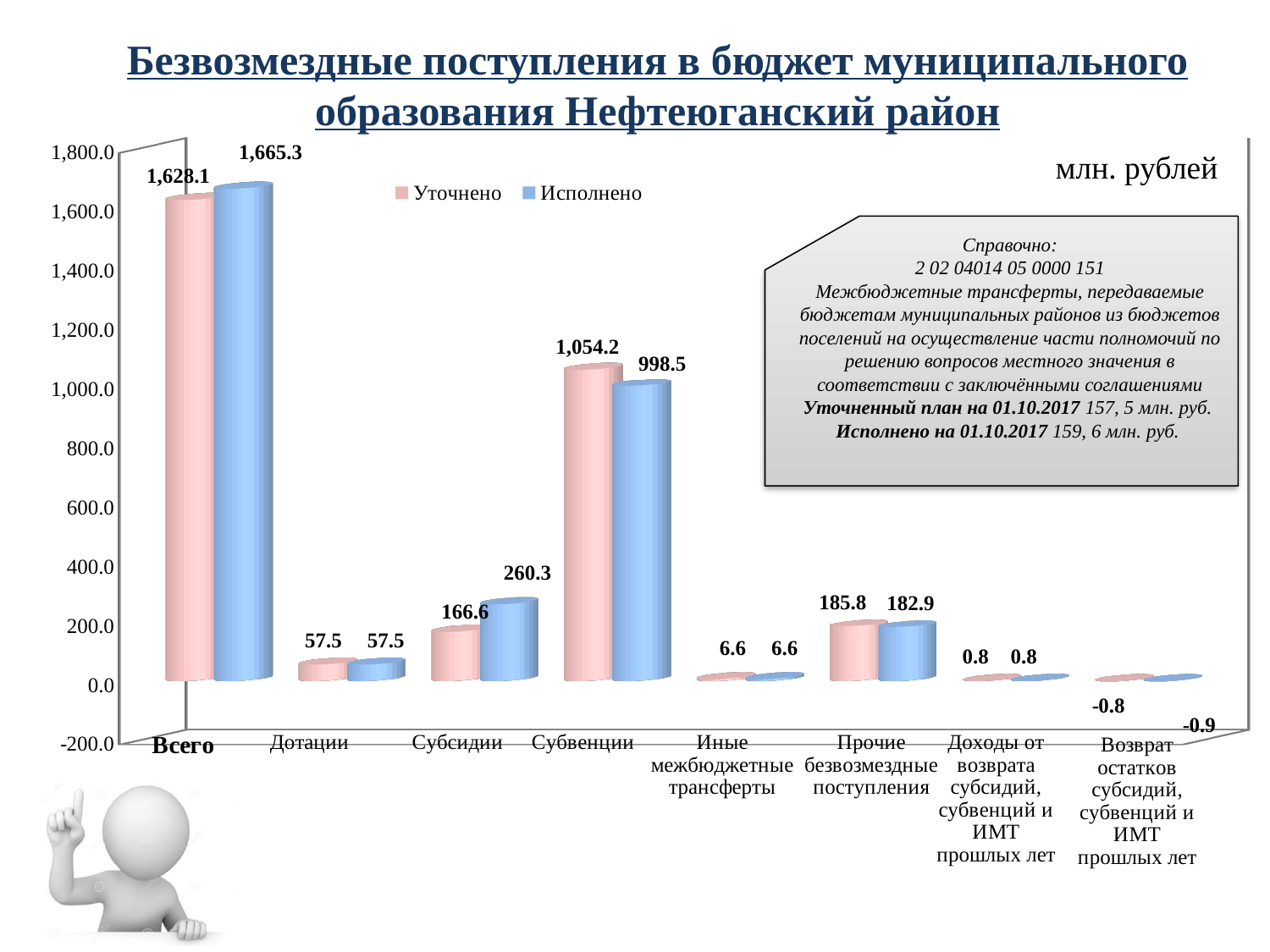
How many categories are shown on the x axis? 8 Which category has the lowest Исполнено value? Возврат остатков субсидий, субвенций и ИМТ прошлых лет What is the Исполнено value for Всего? 1,665.3 What is the Исполнено value for Субсидии? 260.3 What is the Уточнено value for Прочие безвозмездные поступления? 185.8 What is the difference between the Исполнено and Уточнено values for Субсидии? 93.7 How many series does the legend list? 2 What are the two series named in the legend? Уточнено and Исполнено For Субвенции, which is larger: the Уточнено value or the Исполнено value? Уточнено Excluding Всего, which category has the highest Исполнено value? Субвенции What is the Уточнено value for Субвенции? 1,054.2 What type of chart is shown on the slide? bar chart